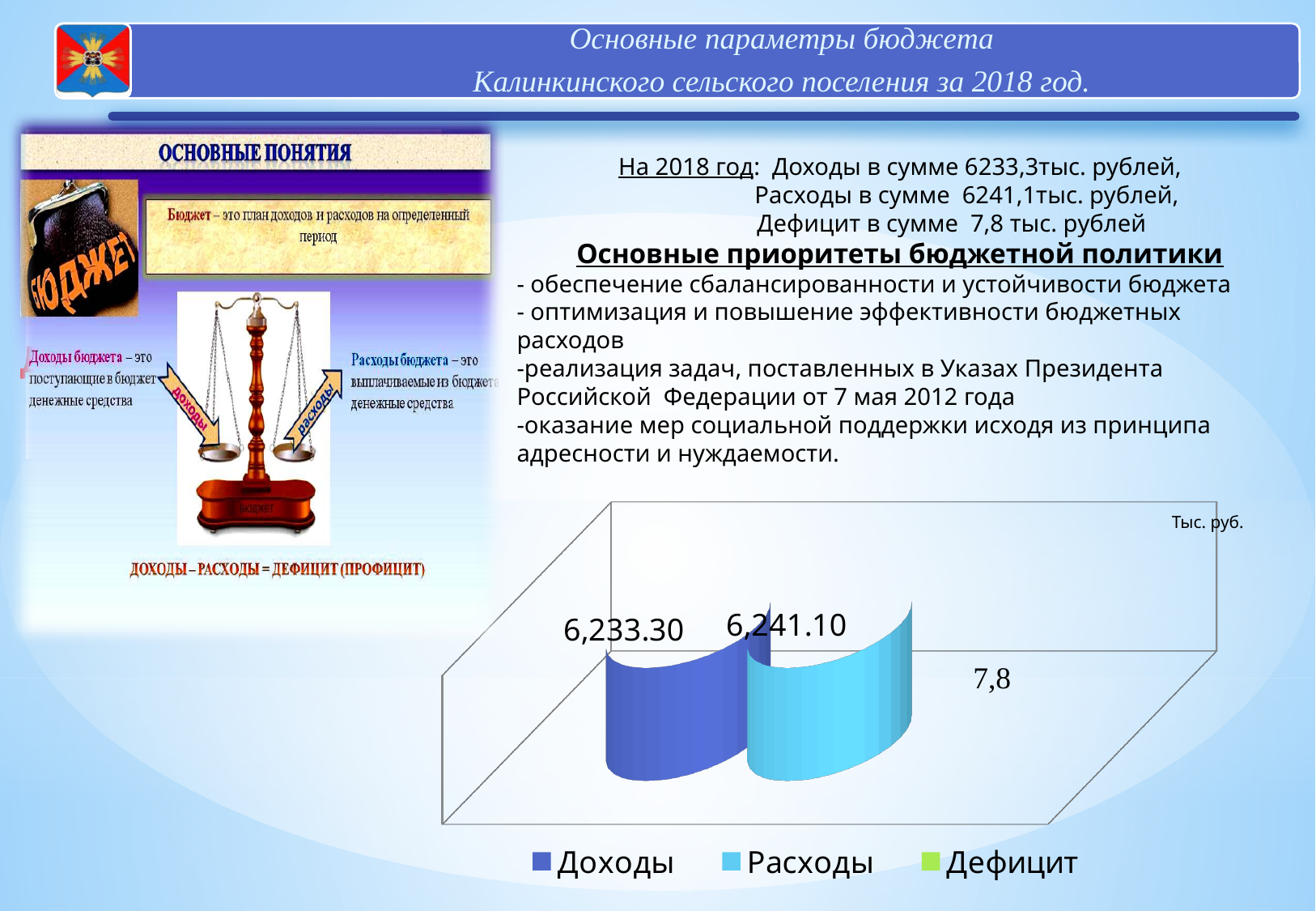
Which is larger in the chart, Доходы or Расходы? Расходы Which legend entry is shown in green in the chart? Дефицит How many series does the chart legend list? 3 What is the value shown for Доходы in the chart? 6,233.30 What is the value shown for Расходы in the chart? 6,241.10 What is the difference between the values for Расходы and Доходы in the chart? 7.80 What unit is indicated in the top right corner of the chart? Тыс. руб. Which series has the lowest value in the chart? Дефицит What kind of chart is shown on the slide? bar chart What is the value shown for Дефицит in the chart? 7,8 Which series has the highest value in the chart? Расходы